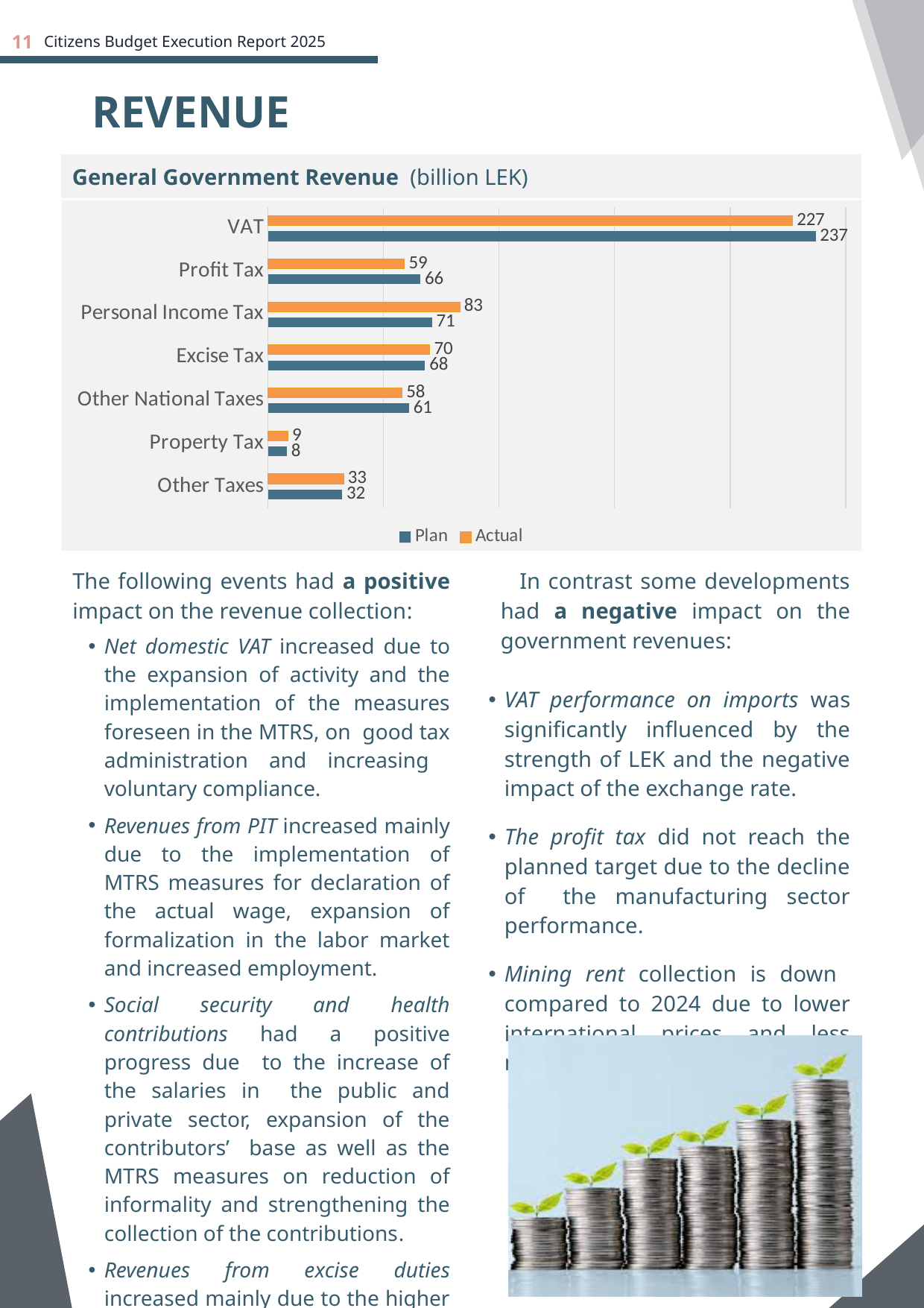
What unit is given in the chart title? billion LEK Which category has the highest Plan value? VAT What is the Plan value for Other National Taxes? 61 Which is larger for Personal Income Tax, the Plan value or the Actual value? Actual What kind of chart is shown on the slide? Bar chart What is the difference between the Plan and Actual values for VAT? 10 What is the Actual value for Personal Income Tax? 83 What is the Plan value for Profit Tax? 66 Which category has the lowest Actual value? Property Tax How many categories are shown on the chart? 7 What is the Actual value for VAT? 227 How many series does the legend list? 2